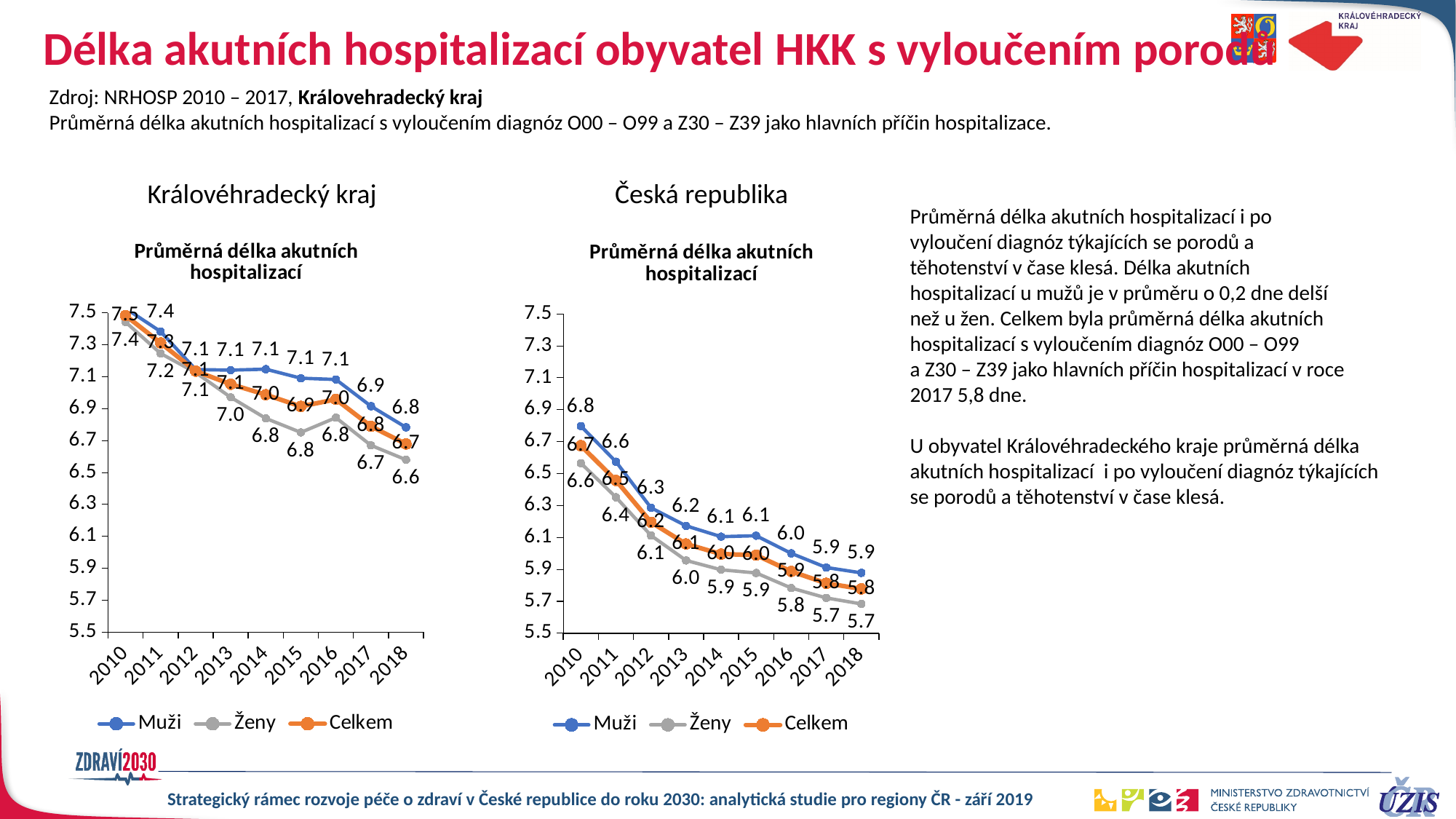
In the Královéhradecký kraj chart, what is the value for Ženy in 2018? 6.6 In the Česká republika chart, what is the value for Celkem in 2018? 5.8 What kind of chart is the Královéhradecký kraj chart? line chart How many series does the legend of the Česká republika chart list? 3 In the Královéhradecký kraj chart, what is the value for Muži in 2018? 6.8 In the Česká republika chart, do the Ženy values rise or fall from 2010 to 2018? fall In the Královéhradecký kraj chart, which year has the highest value for Muži? 2010 How many years are plotted on the x axis of the Královéhradecký kraj chart? 9 In the Česká republika chart, what is the value for Ženy in 2018? 5.7 In the Česká republika chart, what is the difference between the Muži value in 2010 and the Muži value in 2018? 0.9 In the Česká republika chart, what is the value for Muži in 2010? 6.8 In the Česká republika chart, which is larger in 2016: the value for Muži or the value for Ženy? Muži